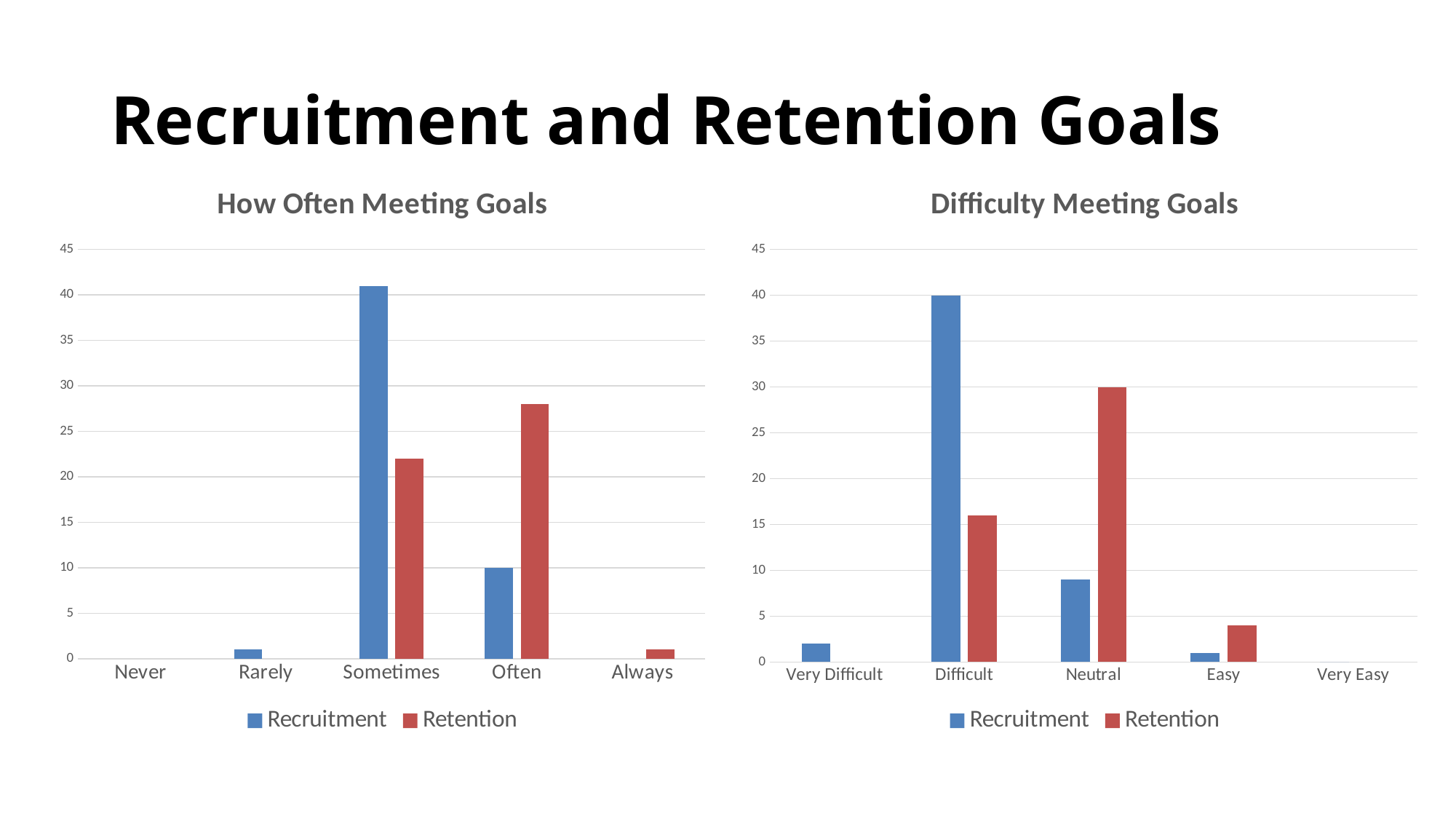
In the 'How Often Meeting Goals' chart, what is the Recruitment value for Often? 10 How many categories are shown on the x axis of the 'Difficulty Meeting Goals' chart? 5 How many series does the legend of the 'How Often Meeting Goals' chart list? 2 In the 'How Often Meeting Goals' chart, is the Retention value for Sometimes greater or less than 20? greater In the 'How Often Meeting Goals' chart, which category has the highest Retention value? Often In the 'How Often Meeting Goals' chart, which is larger for Often, Recruitment or Retention? Retention In the 'Difficulty Meeting Goals' chart, what is the Recruitment value for Difficult? 40 In the 'Difficulty Meeting Goals' chart, is the Retention value for Difficult greater or less than 20? less In the 'Difficulty Meeting Goals' chart, which category has the highest Retention value? Neutral In the 'Difficulty Meeting Goals' chart, which is larger for Difficult, Recruitment or Retention? Recruitment In the 'Difficulty Meeting Goals' chart, what is the Retention value for Neutral? 30 In the 'How Often Meeting Goals' chart, which category has the highest Recruitment value? Sometimes